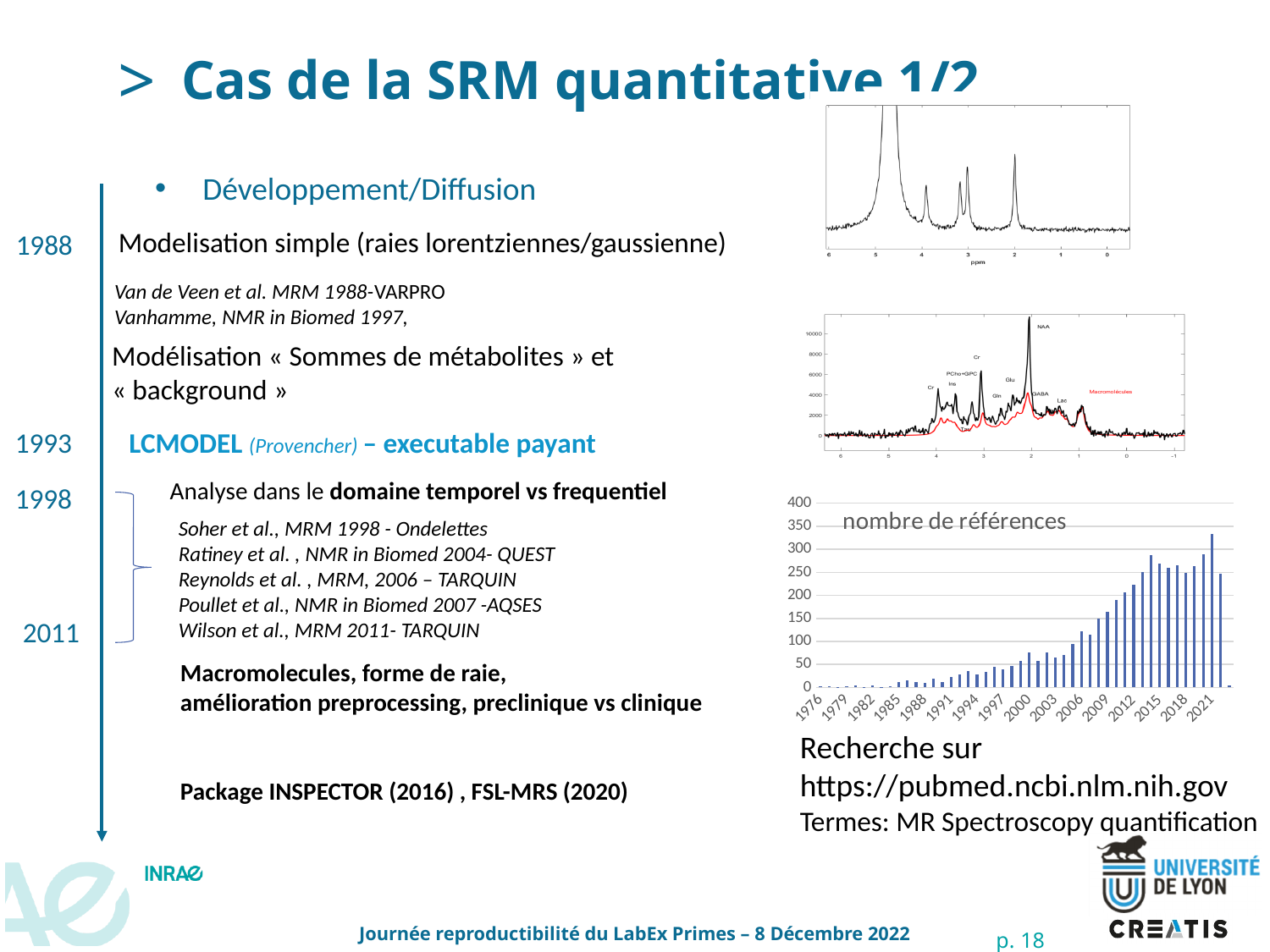
What is the title of the bar chart on the right of the slide? nombre de références In the 'nombre de références' chart, is the value for 1994 greater or less than 100? less In the 'nombre de références' chart, is the value for 2021 greater or less than 200? greater In the 'nombre de références' chart, which year has the larger value, 1988 or 2006? 2006 In the 'nombre de références' chart, which year has the larger value, 1985 or 2015? 2015 In the 'nombre de références' chart, do the values generally rise or fall from 1976 to the 2020s? rise What is the highest tick value shown on the y axis of the 'nombre de références' chart? 400 What kind of chart is the 'nombre de références' chart? bar chart In the 'nombre de références' chart, is the value for 2009 greater or less than 100? greater